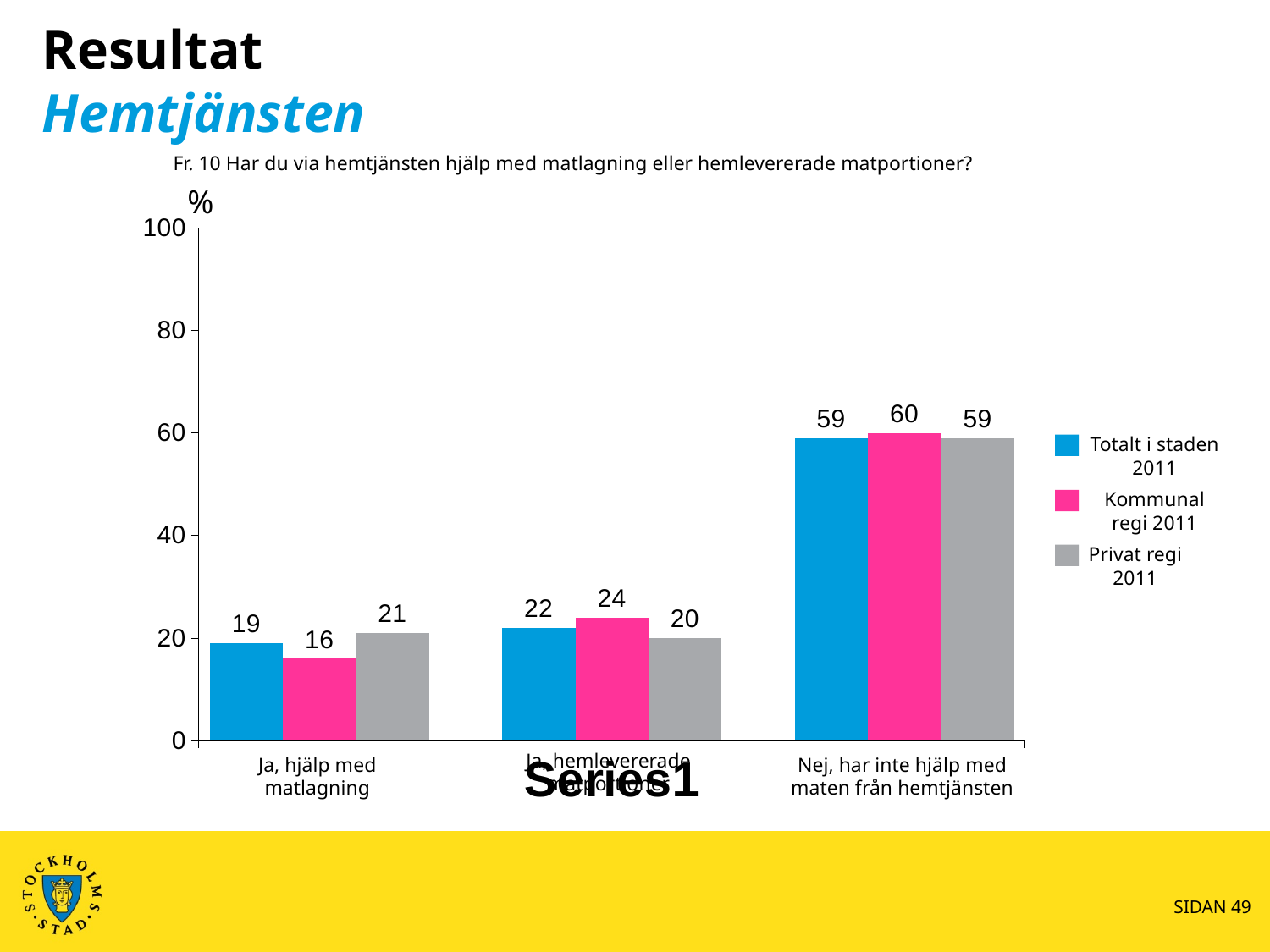
What is the difference between Kommunal regi 2011 and Privat regi 2011 in the middle category? 4 What is the value for Kommunal regi 2011 in the middle category? 24 What is the value for Totalt i staden 2011 in the category "Ja, hjälp med matlagning"? 19 What unit is shown at the top of the y axis? % How many series does the legend list? 3 Which category has the highest value for Totalt i staden 2011? Nej, har inte hjälp med maten från hemtjänsten What is the value for Kommunal regi 2011 in the category "Ja, hjälp med matlagning"? 16 In the category "Ja, hjälp med matlagning", which is larger: Privat regi 2011 or Totalt i staden 2011? Privat regi 2011 How many categories are shown on the x axis? 3 What is the value for Privat regi 2011 in the category "Nej, har inte hjälp med maten från hemtjänsten"? 59 What kind of chart is shown on the slide? Bar chart Which series has the lowest value in the category "Ja, hjälp med matlagning"? Kommunal regi 2011